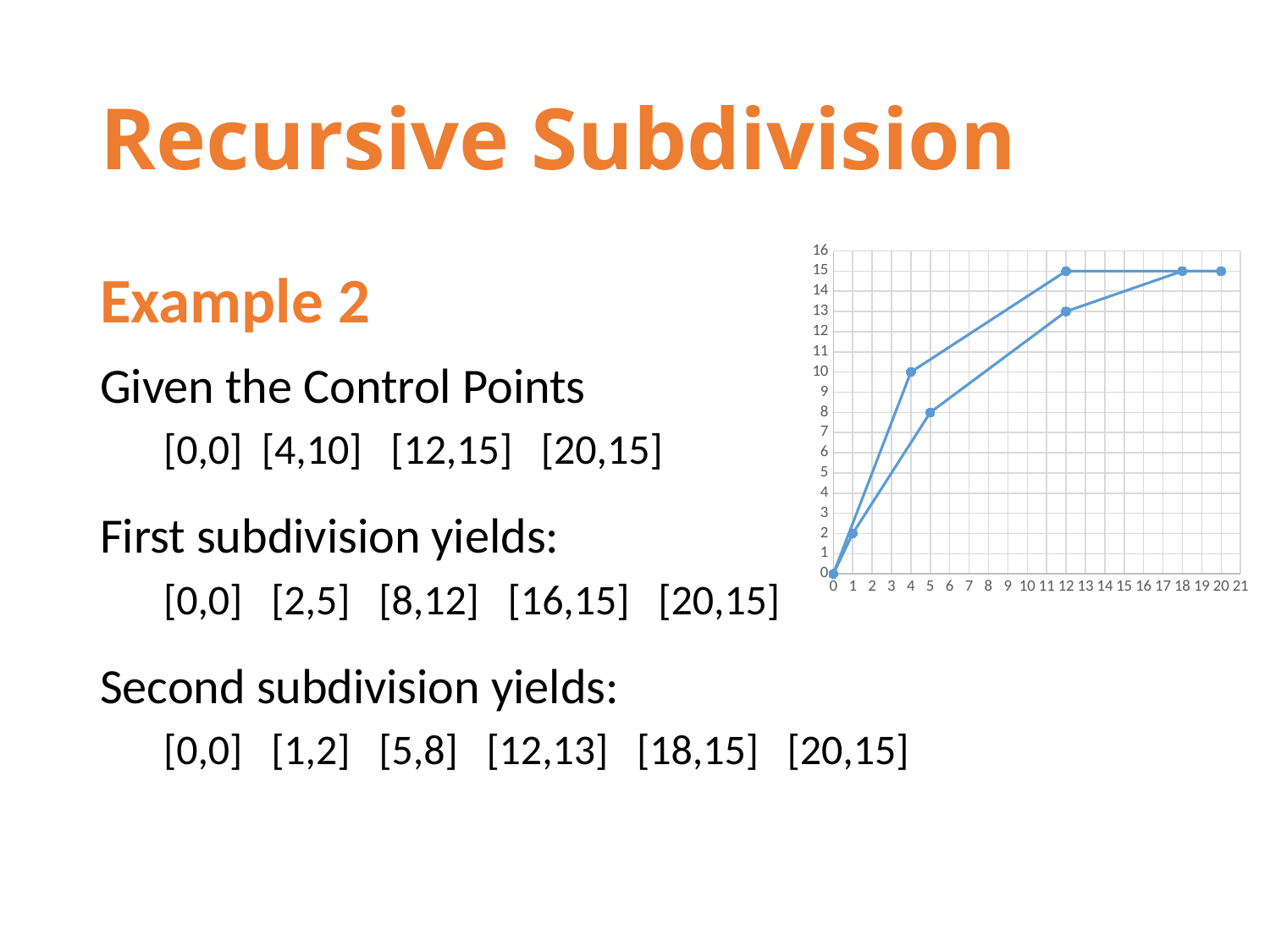
On the lower line, what is the y value of the point at x = 5? 8 What kind of chart is shown on the slide? line chart On the lower line, what is the y value of the point at x = 18? 15 Is the y value of the lower line at x = 12 greater or less than 10? greater At x = 12, which line has the higher y value, the upper line or the lower line? the upper line How many plotted points does the lower line (the second subdivision) have? 6 What is the highest y value reached by either line in the chart? 15 On the upper line, what is the y value of the point at x = 4? 10 At x = 12, what is the difference between the y values of the upper line and the lower line? 2 Do the y values of the lines rise or fall as x increases? rise What is the largest tick label shown on the y axis of the chart? 16 How many plotted points does the upper line (the control points) have? 4